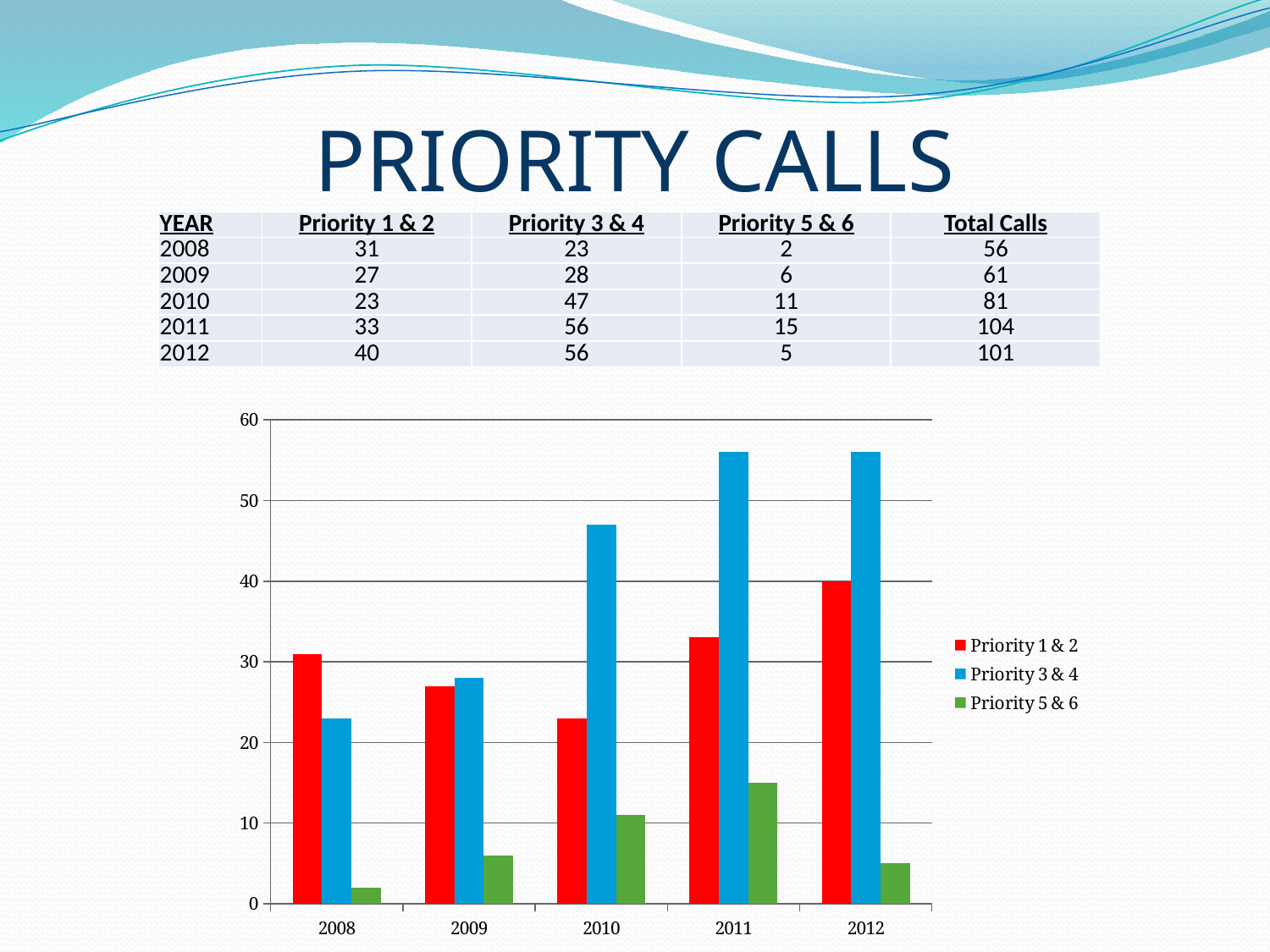
What is the value for Priority 1 & 2 in 2012? 40 In which year is the Priority 1 & 2 value highest? 2012 What is the difference between the Priority 3 & 4 value and the Priority 1 & 2 value in 2011? 23 Is the value for Priority 3 & 4 in 2012 greater or less than 50? greater Which colour represents Priority 5 & 6 in the chart? green How many years are shown on the x axis of the chart? 5 Which is larger in 2009, Priority 1 & 2 or Priority 3 & 4? Priority 3 & 4 What is the value for Priority 5 & 6 in 2011? 15 What kind of chart is shown on the slide? bar chart In which year is the Priority 5 & 6 value lowest? 2008 What is the value for Priority 3 & 4 in 2010? 47 How many series does the chart's legend list? 3